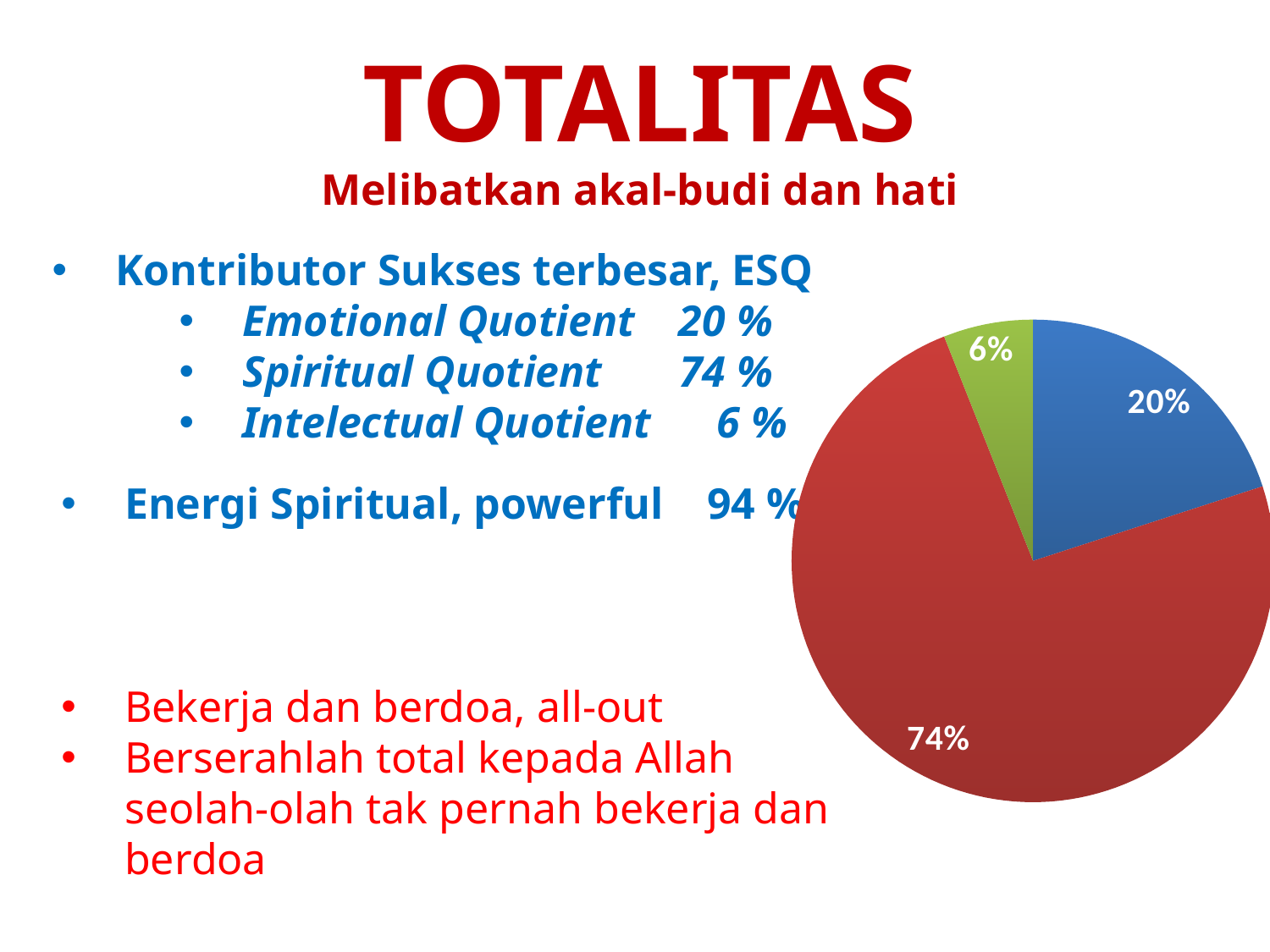
What colour is the largest slice of the pie chart? red Which is larger in the pie chart, the blue slice or the green slice? the blue slice What kind of chart is shown on the slide? pie chart What percentage is shown on the green slice of the pie chart? 6% What percentage is shown on the red slice of the pie chart? 74% According to the slide text, which quotient does the 74% slice of the pie chart represent? Spiritual Quotient How many slices does the pie chart have? 3 Which slice of the pie chart is the smallest? the green slice (6%) Which slice of the pie chart is the largest? the red slice (74%) What percentage is shown on the blue slice of the pie chart? 20% What is the difference between the red slice and the blue slice in the pie chart? 54% What is the difference between the blue slice and the green slice in the pie chart? 14%